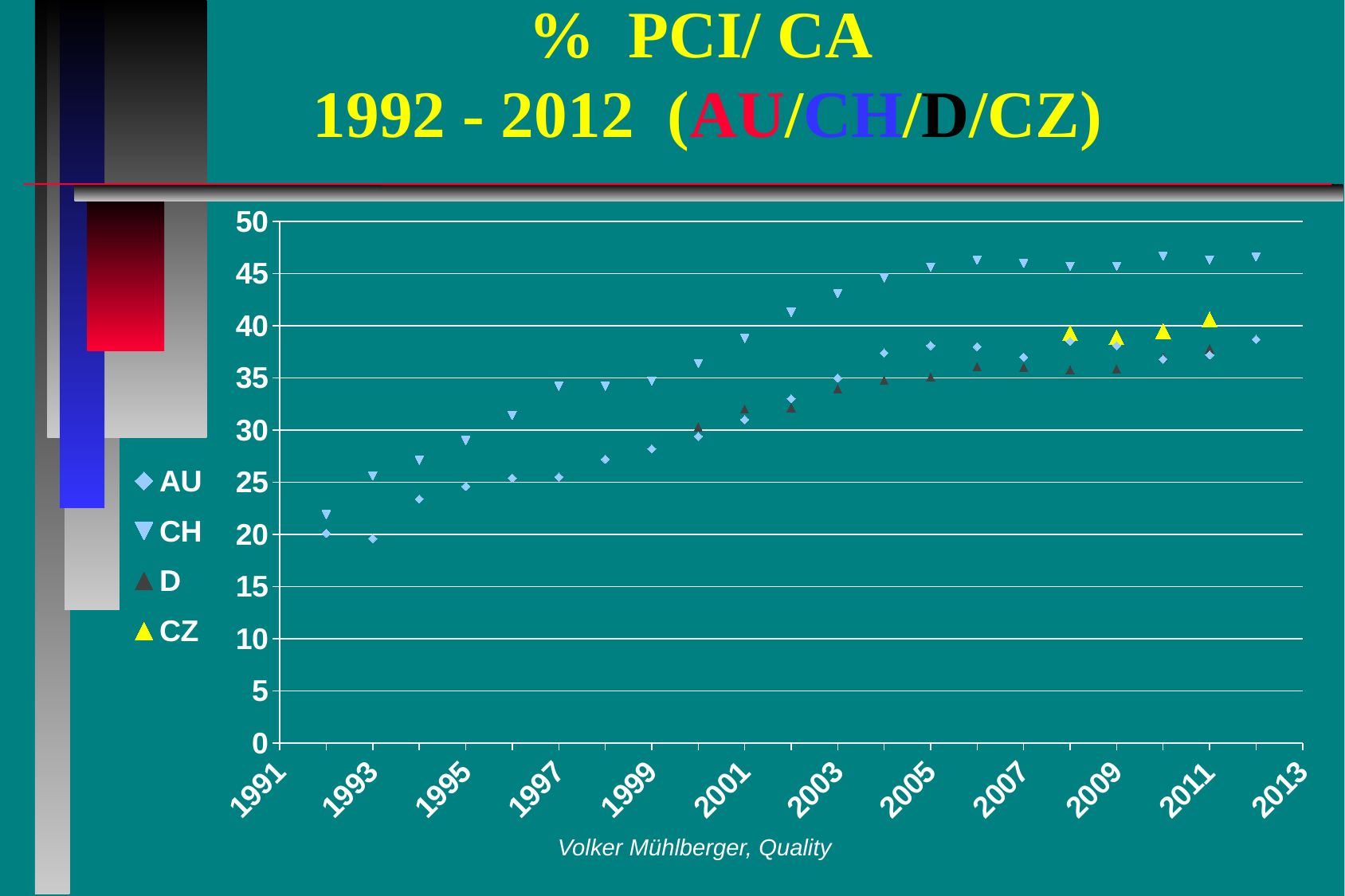
How many series does the legend list? 4 Is the value for CH in 2012 greater or less than 45? greater Is the value for AU in 1992 greater or less than 25? less Is the value for AU in 1999 greater or less than 30? less Which series has the highest value in 2012? CH How many data points are plotted for the CZ series? 4 Do the CH values rise or fall from 1992 to 2012? rise Which is larger in 2012, the value for CH or the value for AU? CH What colour is the marker for the CZ series in the legend? yellow Which is larger in 2010, the value for CZ or the value for D? CZ What kind of chart is shown on the slide? scatter chart